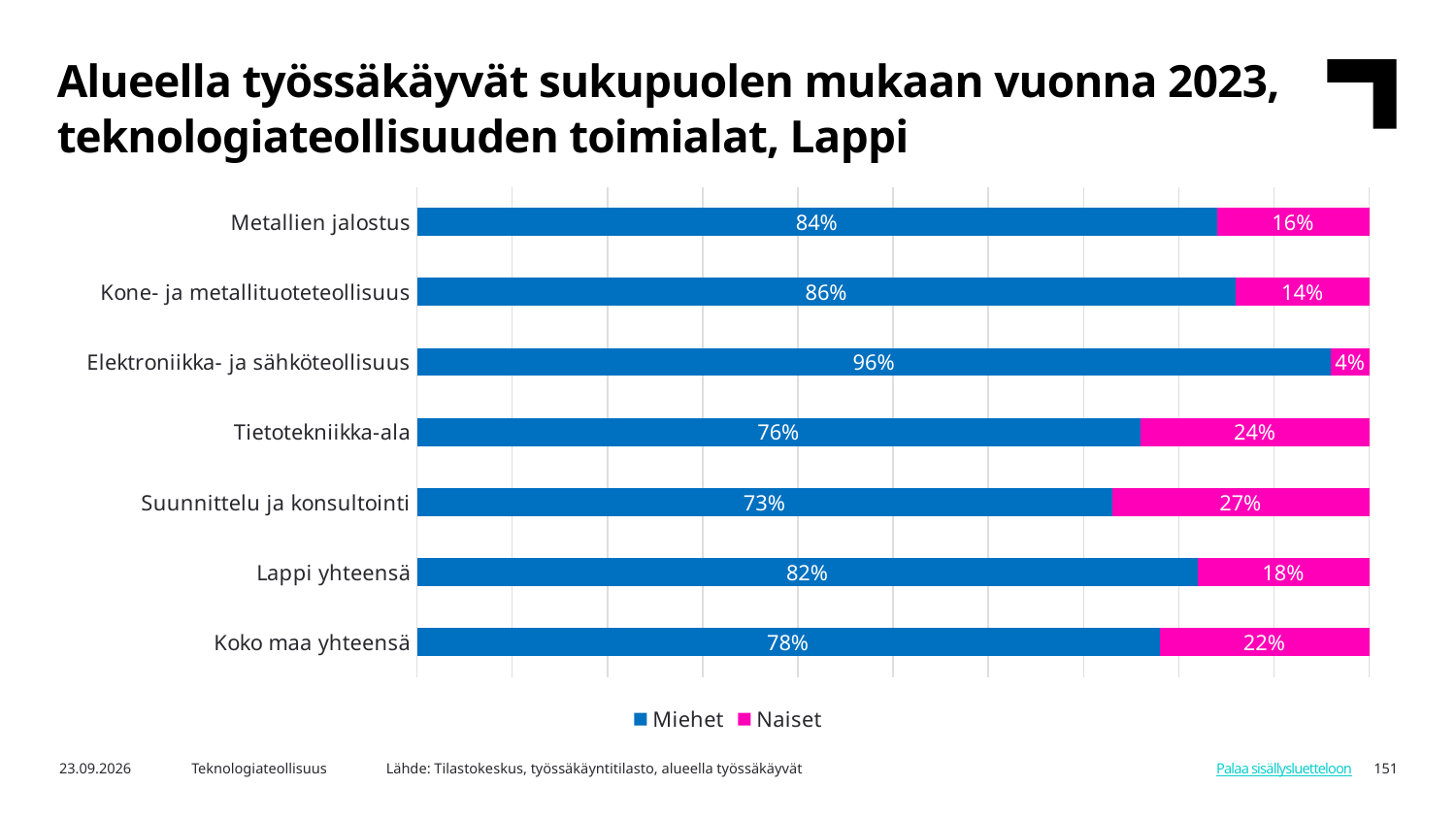
Which category has the highest Miehet share? Elektroniikka- ja sähköteollisuus What is the difference between the Naiset share for Tietotekniikka-ala and the Naiset share for Kone- ja metallituoteteollisuus? 10 percentage points What is the Miehet share for Koko maa yhteensä? 78% How many series does the legend list? 2 Which category has the lowest Miehet share? Suunnittelu ja konsultointi What is the Miehet share for Metallien jalostus? 84% What is the Naiset share for Elektroniikka- ja sähköteollisuus? 4% What is the total of the stacked bar for Lappi yhteensä? 100% What is the Naiset share for Suunnittelu ja konsultointi? 27% Which is larger: the Naiset share for Lappi yhteensä or the Naiset share for Koko maa yhteensä? Koko maa yhteensä What kind of chart is shown on the slide? Stacked bar chart How many categories are shown on the chart? 7